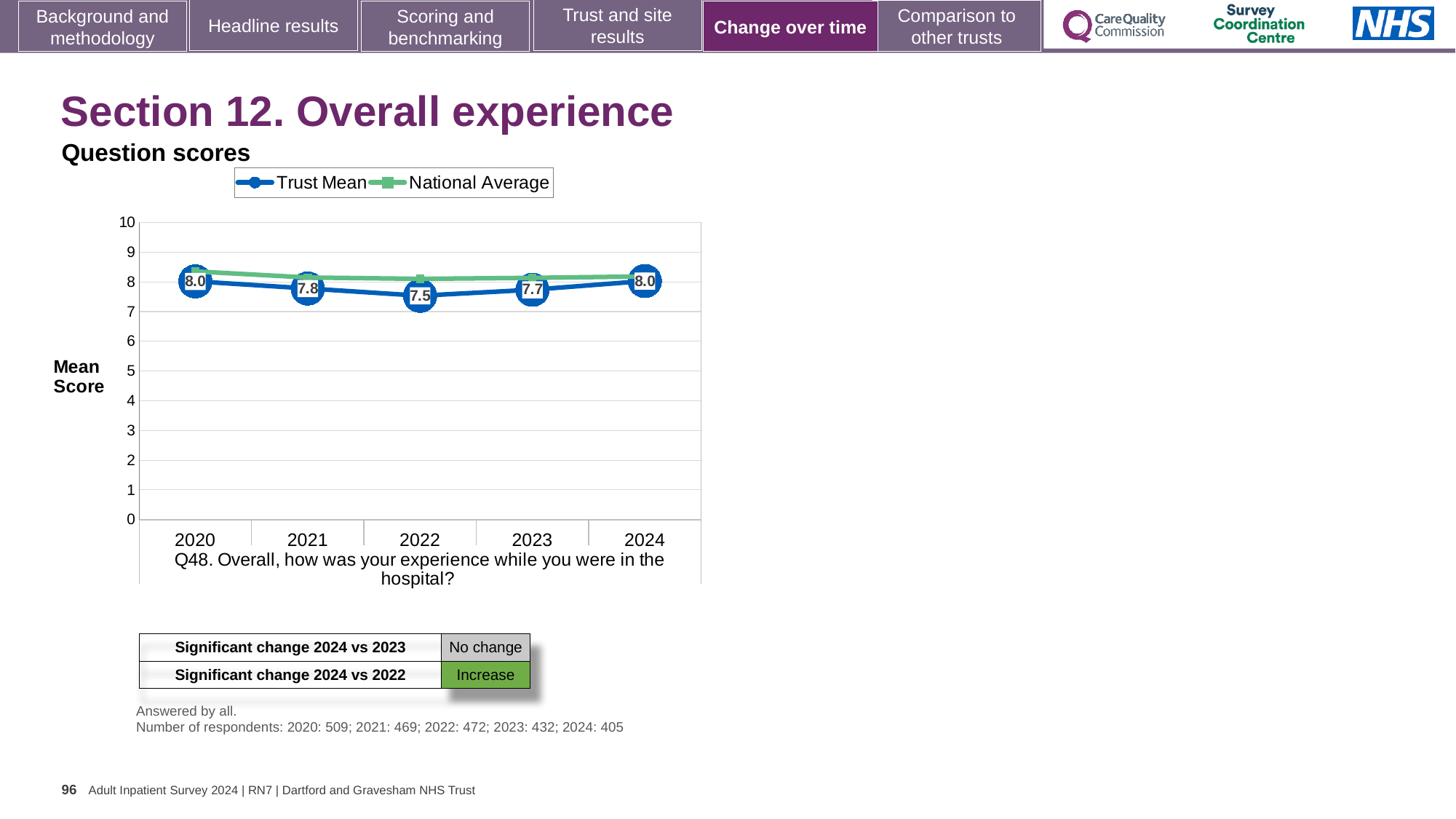
What is the Trust Mean score for 2020? 8.0 Does the Trust Mean score rise or fall from 2022 to 2024? Rise What is the difference between the Trust Mean score in 2024 and in 2022? 0.5 What is the label on the y axis of the chart? Mean Score In which year is the Trust Mean score lowest? 2022 What is the Trust Mean score for 2022? 7.5 Is the National Average value for 2020 greater or less than 8? greater How many series does the legend list? 2 How many years are plotted on the x axis? 5 What kind of chart is shown on the slide? Line chart Which year has the higher Trust Mean score, 2021 or 2023? 2021 What is the Trust Mean score for 2023? 7.7